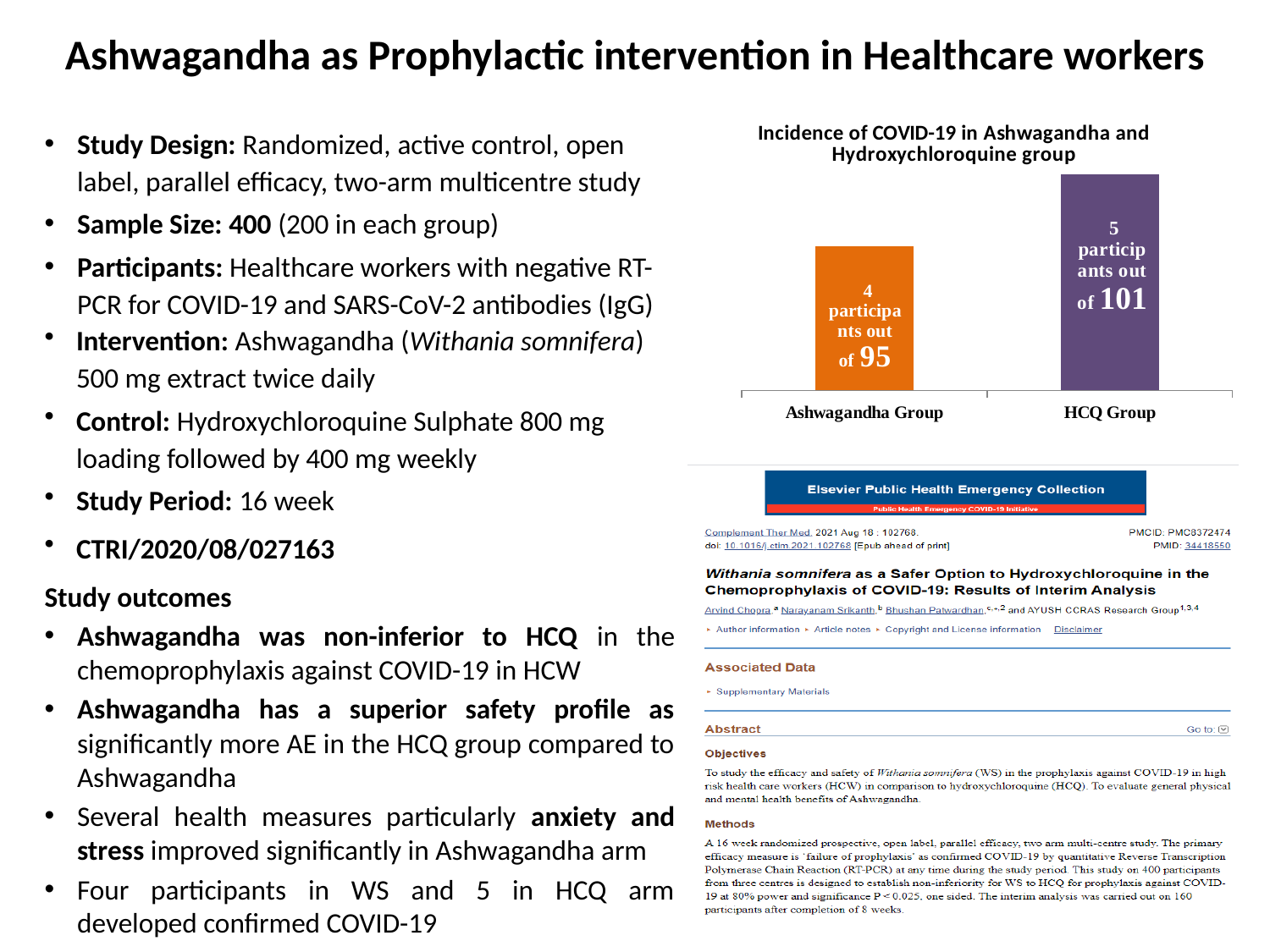
How many participants in the Ashwagandha Group developed COVID-19 according to the chart? 4 Which group had more participants with COVID-19, the Ashwagandha Group or the HCQ Group? HCQ Group Which group has the higher bar in the chart? HCQ Group Which group has the lower bar in the chart? Ashwagandha Group How many groups (bars) are shown in the chart? 2 How many participants in the HCQ Group developed COVID-19 according to the chart? 5 What kind of chart is shown on the slide? bar chart What does the bar label say for the HCQ Group? 5 participants out of 101 What is the chart title? Incidence of COVID-19 in Ashwagandha and Hydroxychloroquine group What does the bar label say for the Ashwagandha Group? 4 participants out of 95 What is the difference in the number of COVID-19 cases between the HCQ Group and the Ashwagandha Group? 1 What colour is the bar for the Ashwagandha Group? orange